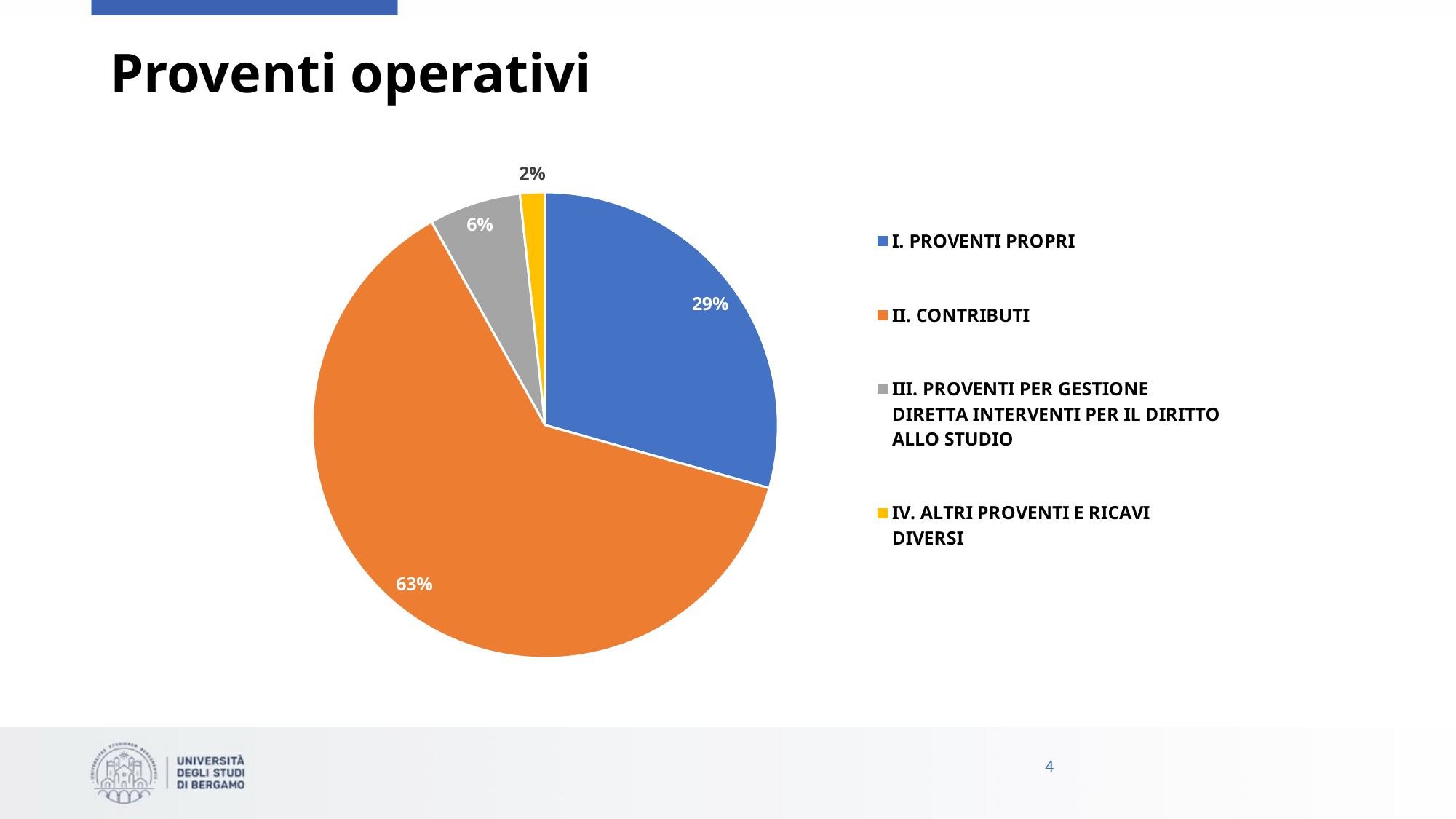
What type of chart is shown on the slide? pie chart What share of the pie does II. CONTRIBUTI represent? 63% How many slices does the pie chart have? 4 What is the difference in percentage points between II. CONTRIBUTI and I. PROVENTI PROPRI? 34 What share of the pie does III. PROVENTI PER GESTIONE DIRETTA INTERVENTI PER IL DIRITTO ALLO STUDIO represent? 6% What is the title of the slide containing the pie chart? Proventi operativi Which category has the largest slice of the pie? II. CONTRIBUTI What colour is the slice for II. CONTRIBUTI? orange What share of the pie does IV. ALTRI PROVENTI E RICAVI DIVERSI represent? 2% Which is larger, the slice for I. PROVENTI PROPRI or the slice for III. PROVENTI PER GESTIONE DIRETTA INTERVENTI PER IL DIRITTO ALLO STUDIO? I. PROVENTI PROPRI Which category has the smallest slice of the pie? IV. ALTRI PROVENTI E RICAVI DIVERSI